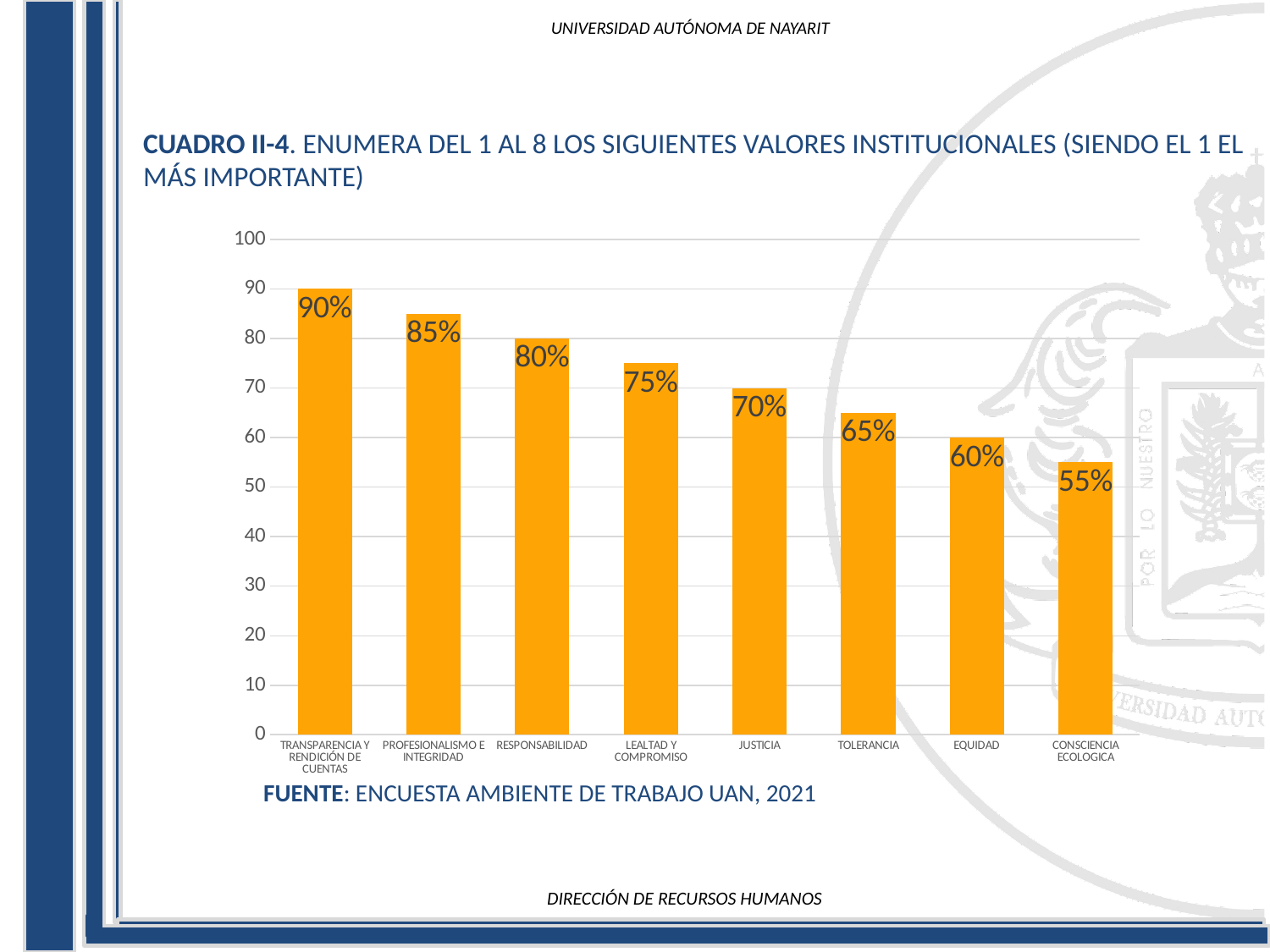
What is the value for JUSTICIA? 70% What kind of chart is shown on the slide? bar chart Which category has the lowest value? CONSCIENCIA ECOLOGICA What is the value for CONSCIENCIA ECOLOGICA? 55% Which category has the highest value? TRANSPARENCIA Y RENDICIÓN DE CUENTAS Is the value for RESPONSABILIDAD greater or less than 70? greater What source is cited below the chart? ENCUESTA AMBIENTE DE TRABAJO UAN, 2021 Do the values rise or fall from left to right along the x axis? fall How many categories are shown on the x axis? 8 Which is larger, the value for LEALTAD Y COMPROMISO or the value for EQUIDAD? LEALTAD Y COMPROMISO What is the value for TRANSPARENCIA Y RENDICIÓN DE CUENTAS? 90% What is the difference between the values for PROFESIONALISMO E INTEGRIDAD and TOLERANCIA? 20%